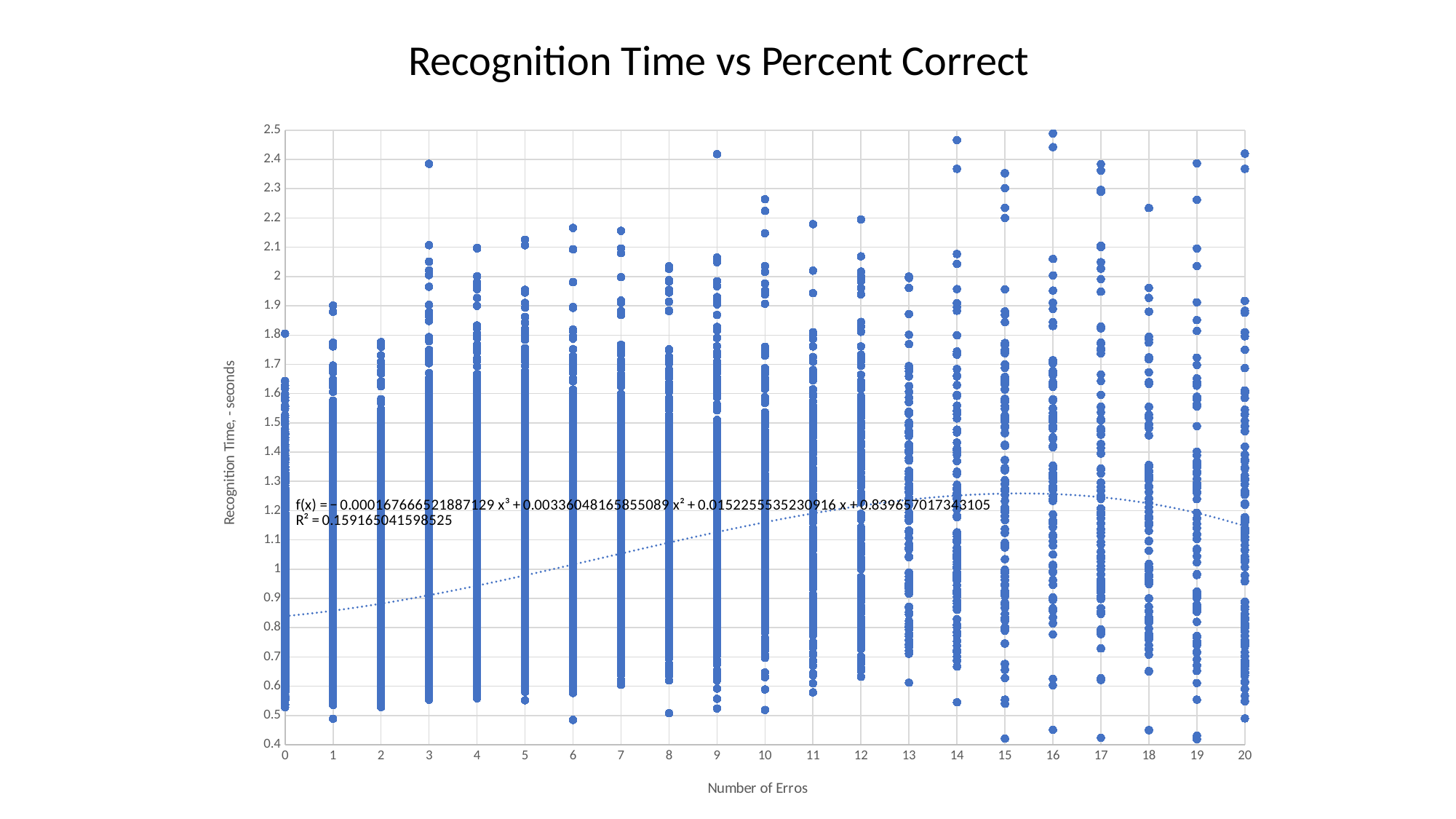
Is the highest recognition time plotted at 16 errors greater or less than 2.4 seconds? greater Is the lowest recognition time plotted at 15 errors greater or less than 0.5 seconds? less What is the label of the x axis? Number of Erros What kind of chart is shown on the slide? Scatter chart What is the lowest value shown on the y axis? 0.4 Is the highest recognition time plotted at 0 errors greater or less than 1.7 seconds? greater How many distinct x-axis values (number of errors) are plotted, from 0 to 20? 21 What R² value is printed on the chart for the trendline? 0.159165041598525 What is the title of the chart? Recognition Time vs Percent Correct Does the dotted trendline rise or fall between 0 and 10 errors? rise What is the highest value shown on the y axis? 2.5